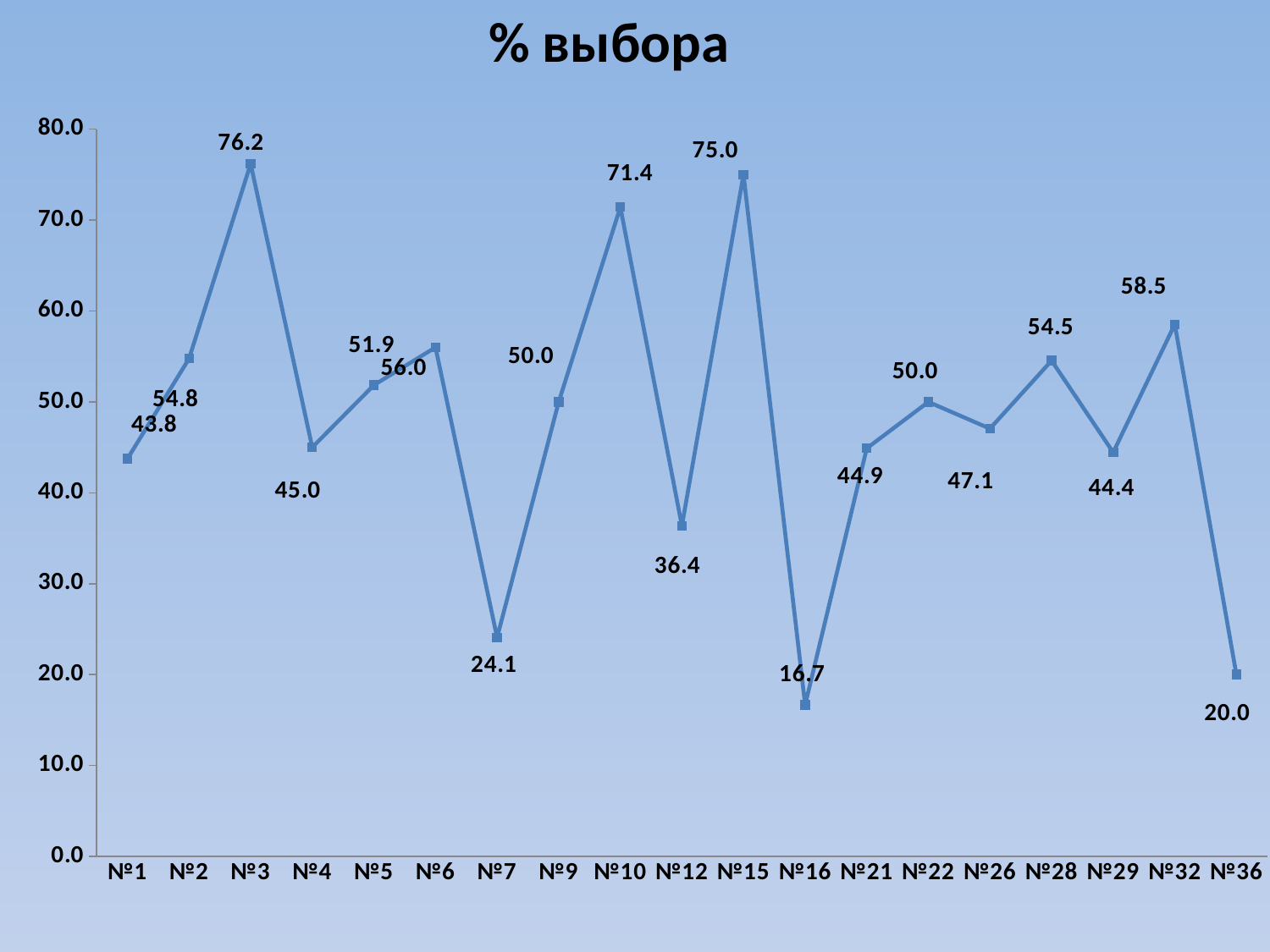
Which category has the highest value? №3 What is the difference between the values for №10 and №12? 35.0 What kind of chart is this? line chart What is the value for №16? 16.7 Which category has the lowest value? №16 Which is larger, the value for №6 or the value for №5? №6 How many categories are shown on the x axis? 19 What is the difference between the values for №3 and №15? 1.2 What is the value for №3? 76.2 What is the value for №36? 20.0 Is the value for №7 greater or less than 30.0? less What is the title of the chart? % выбора